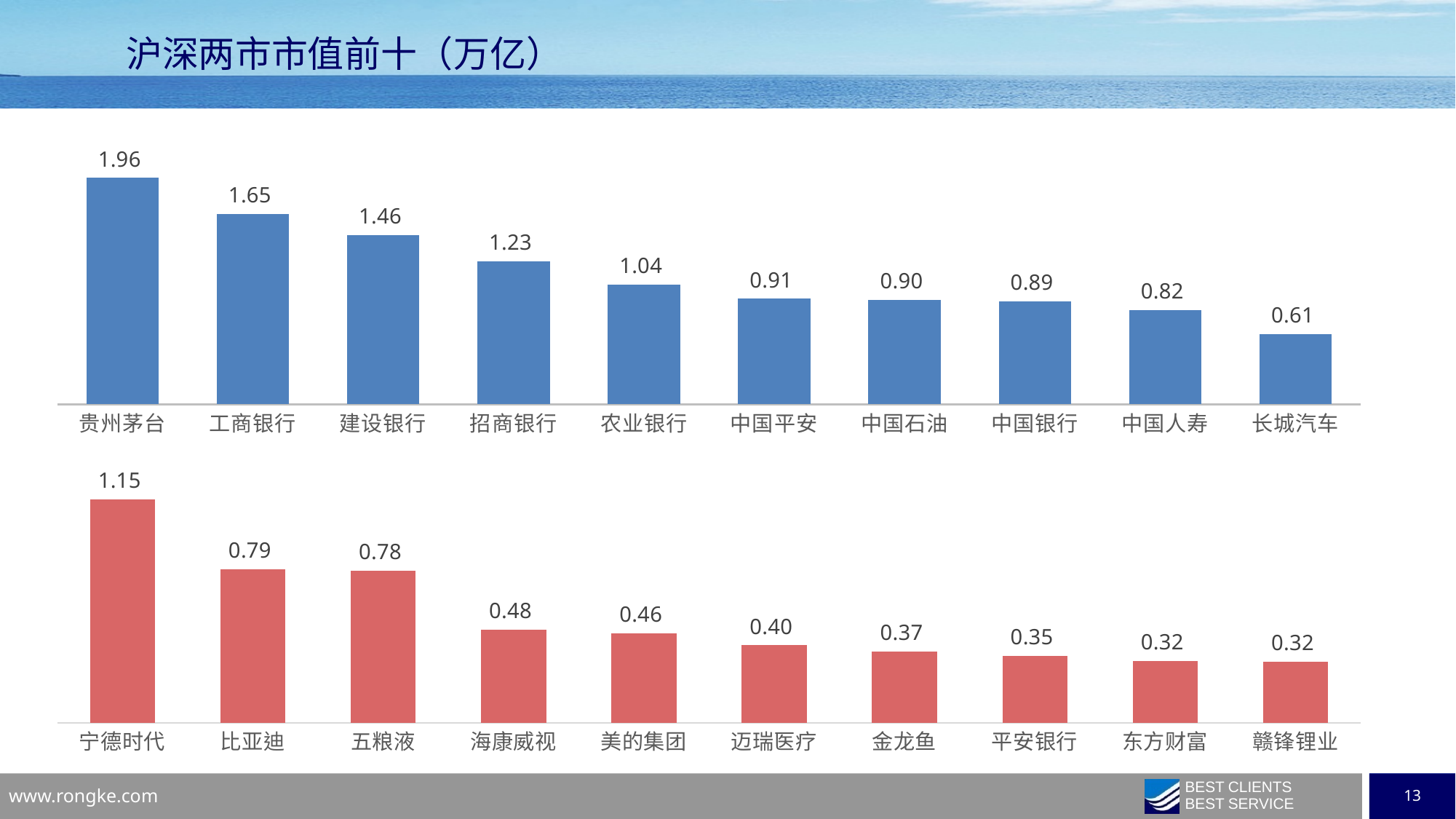
In the top (blue) chart, what is the value for 贵州茅台? 1.96 In the top (blue) chart, what is the difference between the values for 工商银行 and 建设银行? 0.19 What kind of chart is the top (blue) chart? bar chart In the bottom (red) chart, what is the difference between the values for 宁德时代 and 海康威视? 0.67 In the top (blue) chart, which category has the lowest value? 长城汽车 In the bottom (red) chart, do the values rise or fall from left to right? fall In the top (blue) chart, which is larger, the value for 招商银行 or the value for 农业银行? 招商银行 In the top (blue) chart, what is the value for 中国人寿? 0.82 In the bottom (red) chart, which category has the highest value? 宁德时代 In the bottom (red) chart, what is the value for 迈瑞医疗? 0.40 How many categories are shown in the bottom (red) chart? 10 In the bottom (red) chart, what is the value for 比亚迪? 0.79